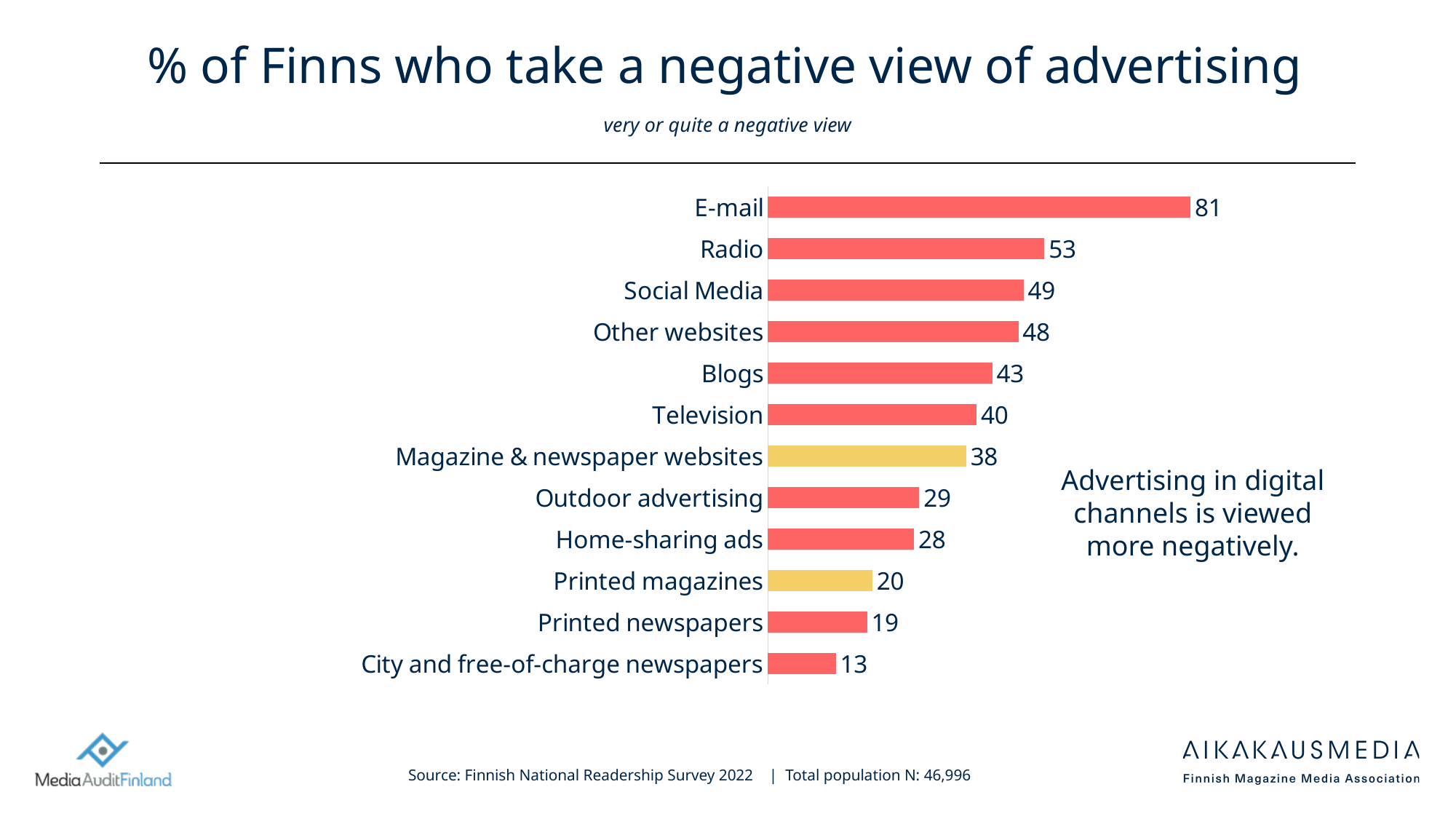
How many categories are shown in the chart? 12 What is the title of the chart? % of Finns who take a negative view of advertising What kind of chart is shown on the slide? Bar chart Which two categories are shown with yellow bars instead of red? Magazine & newspaper websites and Printed magazines What is the value for Magazine & newspaper websites? 38 What is the difference between the values for Television and Printed newspapers? 21 Which category has the lowest value? City and free-of-charge newspapers What is the value for Printed magazines? 20 Which has a larger value, Blogs or Outdoor advertising? Blogs Which category has the highest value? E-mail What is the value for E-mail? 81 What is the difference between the values for E-mail and Radio? 28